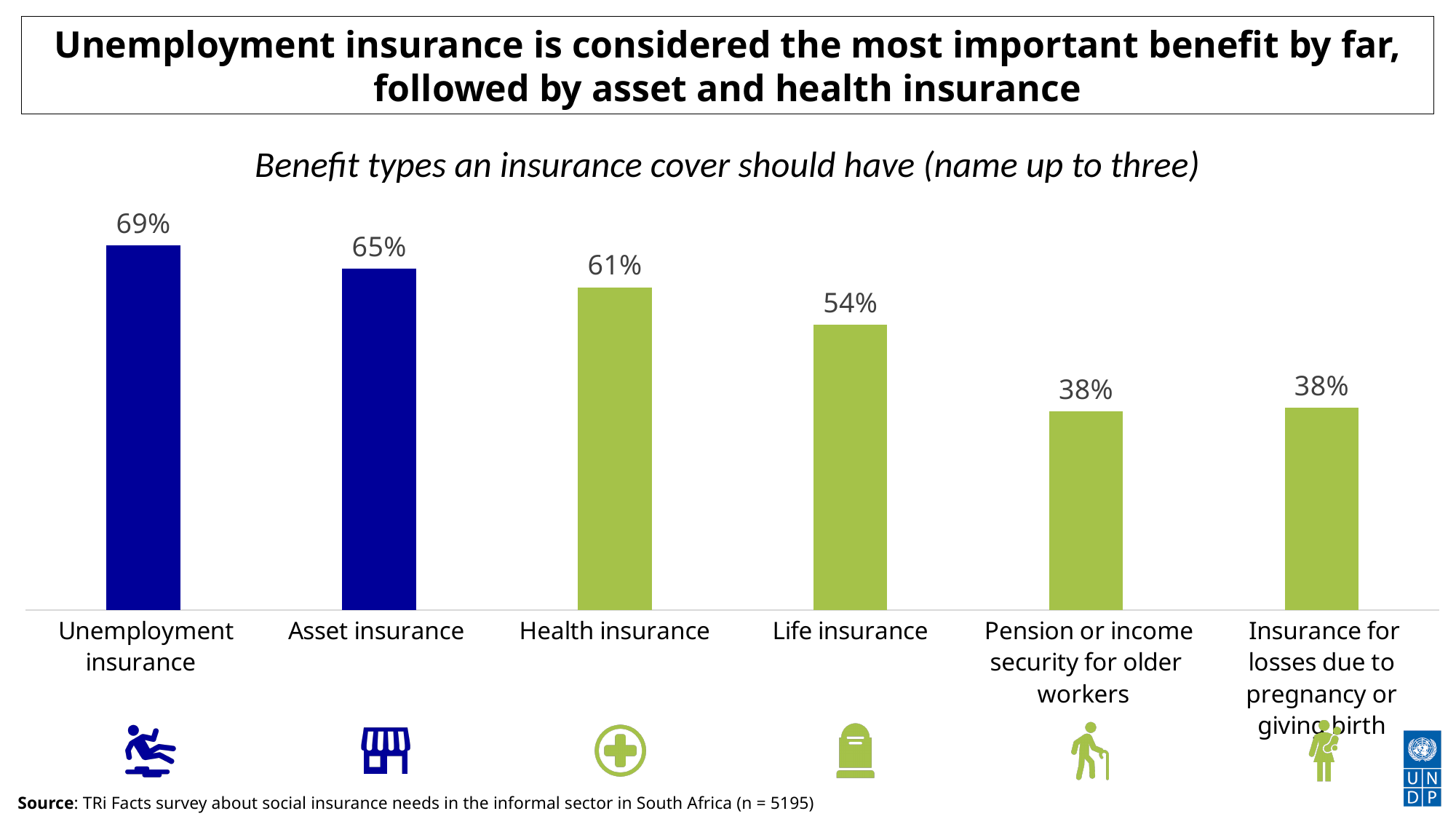
What is the difference between the values for health insurance and life insurance? 7% What is the value shown for life insurance? 54% Do the values rise or fall from left to right across the chart? Fall Which benefit type has the highest value in the chart? Unemployment insurance What is the value for pension or income security for older workers? 38% What is the title of the chart? Benefit types an insurance cover should have (name up to three) What percentage of respondents named unemployment insurance as a benefit an insurance cover should have? 69% Which has a higher value, asset insurance or health insurance? Asset insurance What is the value shown for health insurance? 61% What kind of chart is shown on the slide? Bar chart What is the difference between the values for unemployment insurance and asset insurance? 4% How many benefit types are shown in the chart? 6